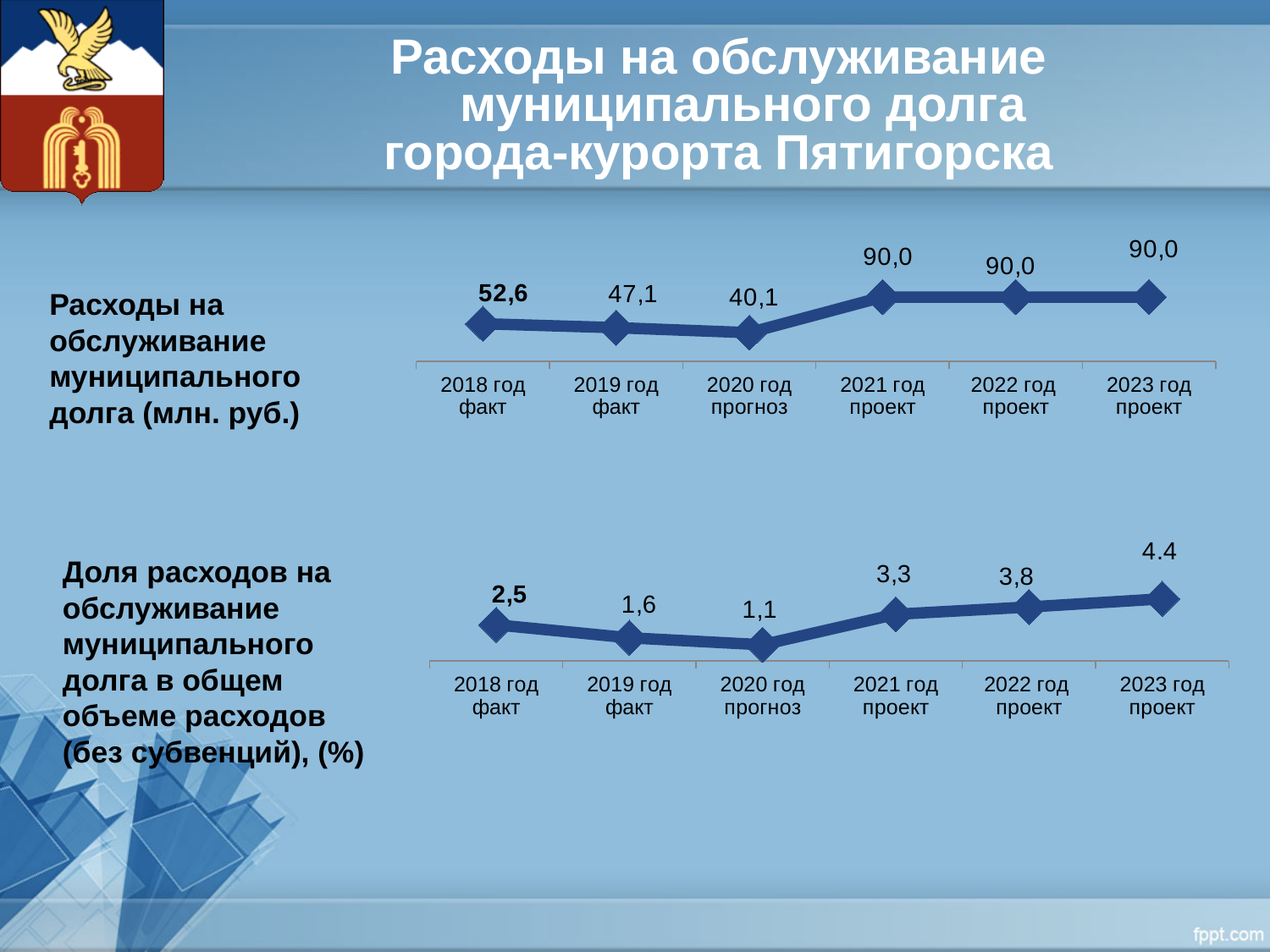
In the bottom chart (share of debt servicing expenses, %), which category has the highest value? 2023 год проект In the bottom chart (share of debt servicing expenses, %), do the values rise or fall from 2020 год прогноз to 2023 год проект? rise In the top chart (expenses on servicing municipal debt, mln rub.), what is the value for 2020 год прогноз? 40,1 In the bottom chart (share of debt servicing expenses, %), what is the value for 2019 год факт? 1,6 In the bottom chart (share of debt servicing expenses, %), what is the difference between the 2018 год факт value and the 2020 год прогноз value? 1,4 What type of chart is the top chart on the slide? line chart In the bottom chart (share of debt servicing expenses, %), what is the value for 2022 год проект? 3,8 In the top chart (expenses on servicing municipal debt, mln rub.), what is the value for 2018 год факт? 52,6 In the bottom chart (share of debt servicing expenses, %), which is larger: the value for 2018 год факт or the value for 2021 год проект? 2021 год проект In the top chart (expenses on servicing municipal debt, mln rub.), which category has the lowest value? 2020 год прогноз In the top chart (expenses on servicing municipal debt, mln rub.), what is the difference between the 2021 год проект value and the 2019 год факт value? 42,9 In the top chart (expenses on servicing municipal debt, mln rub.), how many data points are plotted? 6